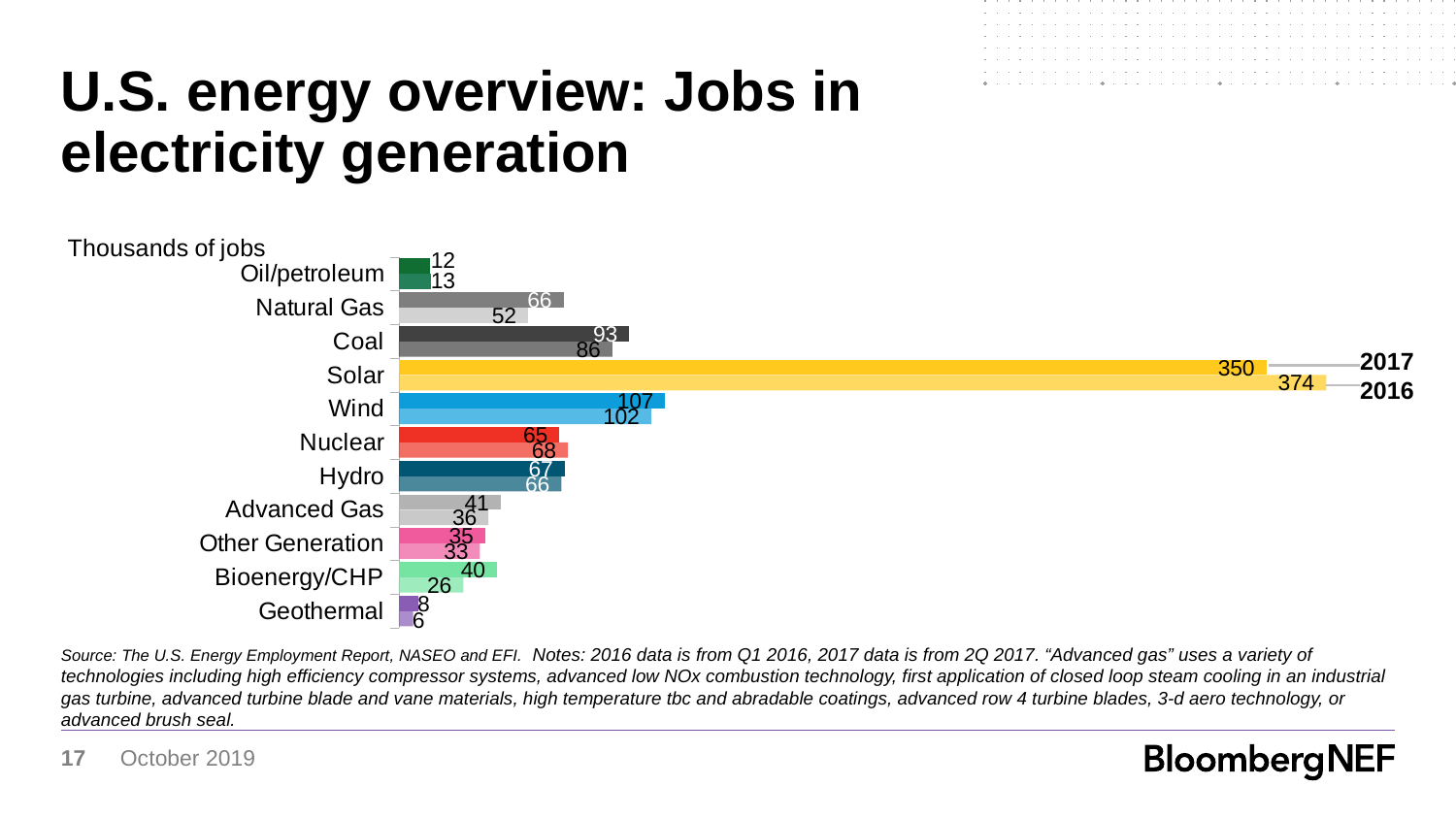
What unit is stated for the values on the chart? Thousands of jobs What is the 2017 value for Bioenergy/CHP? 40 What kind of chart is shown on the slide? Bar chart What is the 2017 value for Solar? 350 How many categories are shown on the chart? 11 Which category has the highest 2017 value? Solar What is the difference between the 2017 and 2016 values for Natural Gas? 14 Which is larger, the 2017 value for Coal or the 2017 value for Wind? Wind How many series does the legend list? 2 What is the difference between the 2016 and 2017 values for Solar? 24 What is the 2016 value for Wind? 102 Which category has the lowest 2016 value? Geothermal